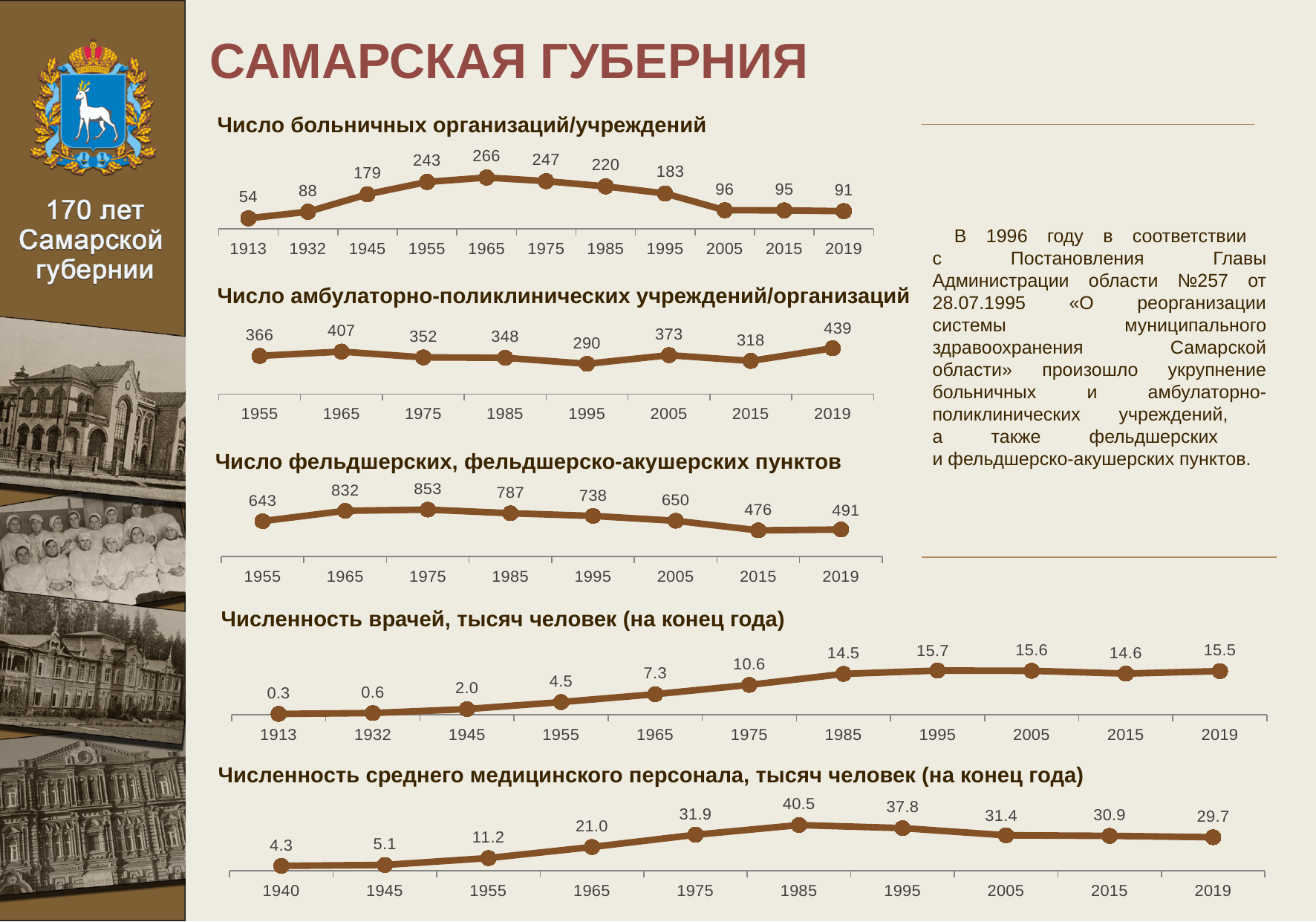
In the chart "Число больничных организаций/учреждений", how many data points are plotted? 11 In the chart "Число фельдшерских, фельдшерско-акушерских пунктов", how many years are shown on the x axis? 8 In the chart "Число амбулаторно-поликлинических учреждений/организаций", which year has the highest value? 2019 In the chart "Число амбулаторно-поликлинических учреждений/организаций", what is the difference between the values for 2019 and 2015? 121 In the chart "Число больничных организаций/учреждений", what is the value for 1965? 266 In the chart "Численность врачей, тысяч человек (на конец года)", do the values rise or fall from 1913 to 1985? rise In the chart "Число фельдшерских, фельдшерско-акушерских пунктов", what is the value for 1975? 853 In the chart "Численность среднего медицинского персонала, тысяч человек (на конец года)", which year has the highest value? 1985 What type of chart is "Численность среднего медицинского персонала, тысяч человек (на конец года)"? line chart In the chart "Численность врачей, тысяч человек (на конец года)", what is the value for 1995? 15.7 In the chart "Число больничных организаций/учреждений", which year has the lowest value? 1913 In the chart "Число фельдшерских, фельдшерско-акушерских пунктов", which is larger, the value for 1955 or the value for 2005? 2005